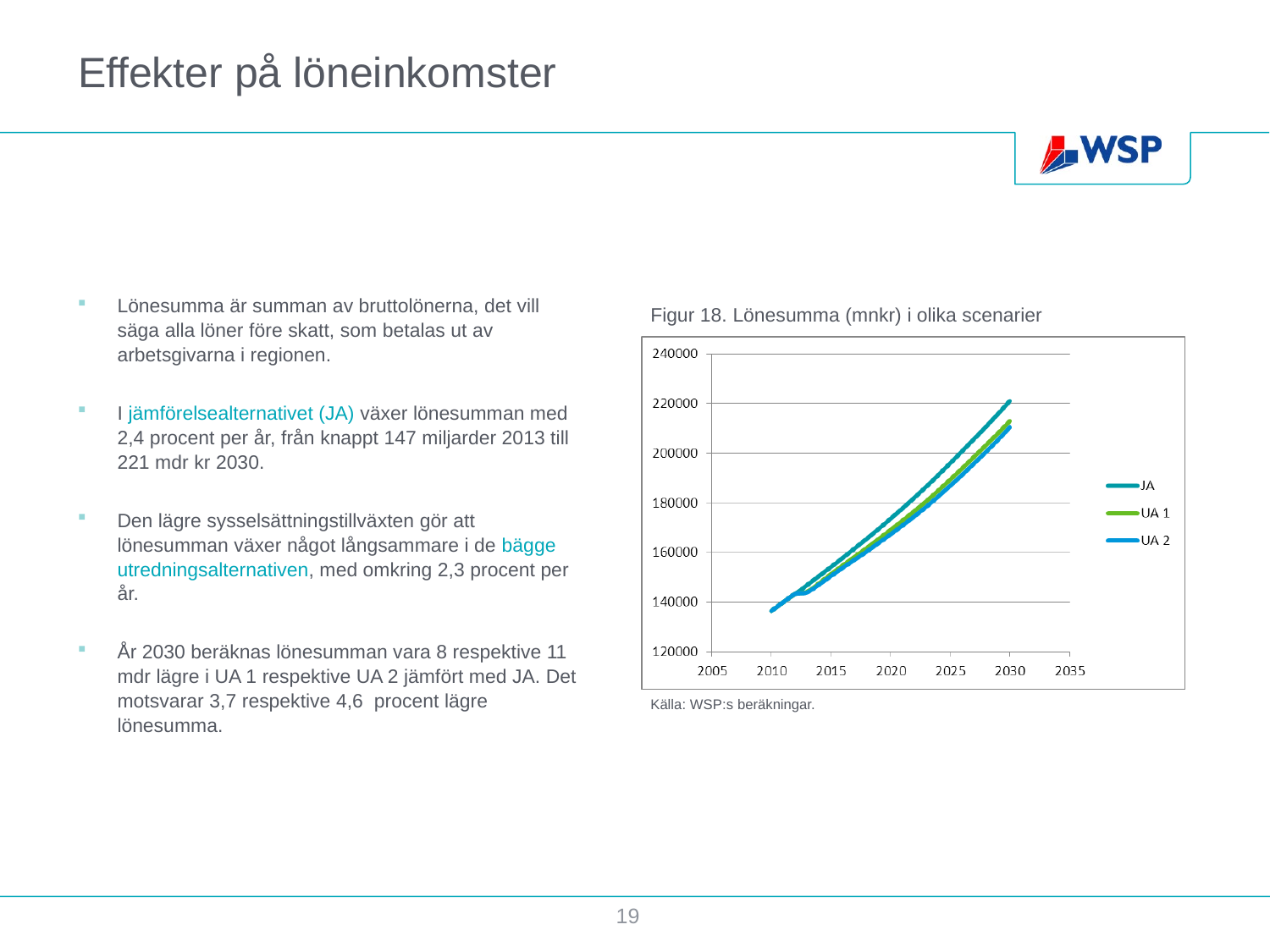
Is the value for UA 2 in 2030 greater or less than 220000? less Do the values in the chart rise or fall from 2010 to 2030? Rise What is the title of the chart? Figur 18. Lönesumma (mnkr) i olika scenarier Which series has the highest value in 2030? JA Is the value for UA 1 in 2020 greater or less than 180000? less In 2030, which is larger: the value for JA or the value for UA 2? JA Is the value for JA in 2010 greater or less than 140000? less What kind of chart is shown in Figur 18? Line chart How many series does the legend of the chart list? 3 Which series are listed in the chart's legend? JA, UA 1, UA 2 What is the highest value shown on the chart's vertical axis? 240000